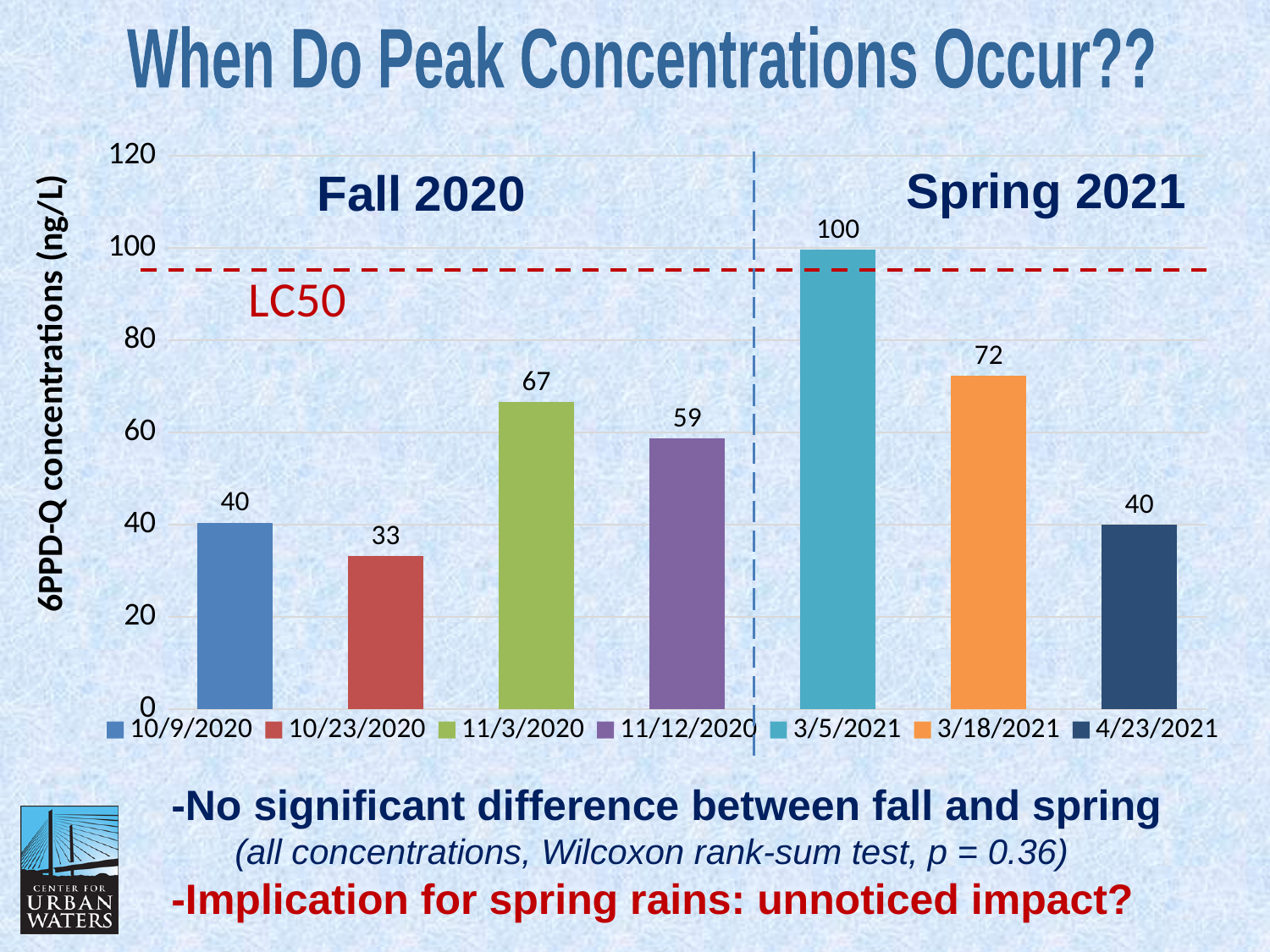
What is the label of the vertical axis? 6PPD-Q concentrations (ng/L) How many entries does the legend list? 7 What is the 6PPD-Q concentration for 10/23/2020? 33 What is the 6PPD-Q concentration for 11/3/2020? 67 What is the difference between the 6PPD-Q concentrations for 3/5/2021 and 3/18/2021? 28 Which date has the highest 6PPD-Q concentration? 3/5/2021 How many bars are plotted in the chart? 7 Which has a higher 6PPD-Q concentration, 11/3/2020 or 11/12/2020? 11/3/2020 What kind of chart is shown on the slide? bar chart Is the 6PPD-Q concentration for 3/18/2021 greater or less than 80? less Which date has the lowest 6PPD-Q concentration? 10/23/2020 What is the 6PPD-Q concentration for 3/5/2021? 100